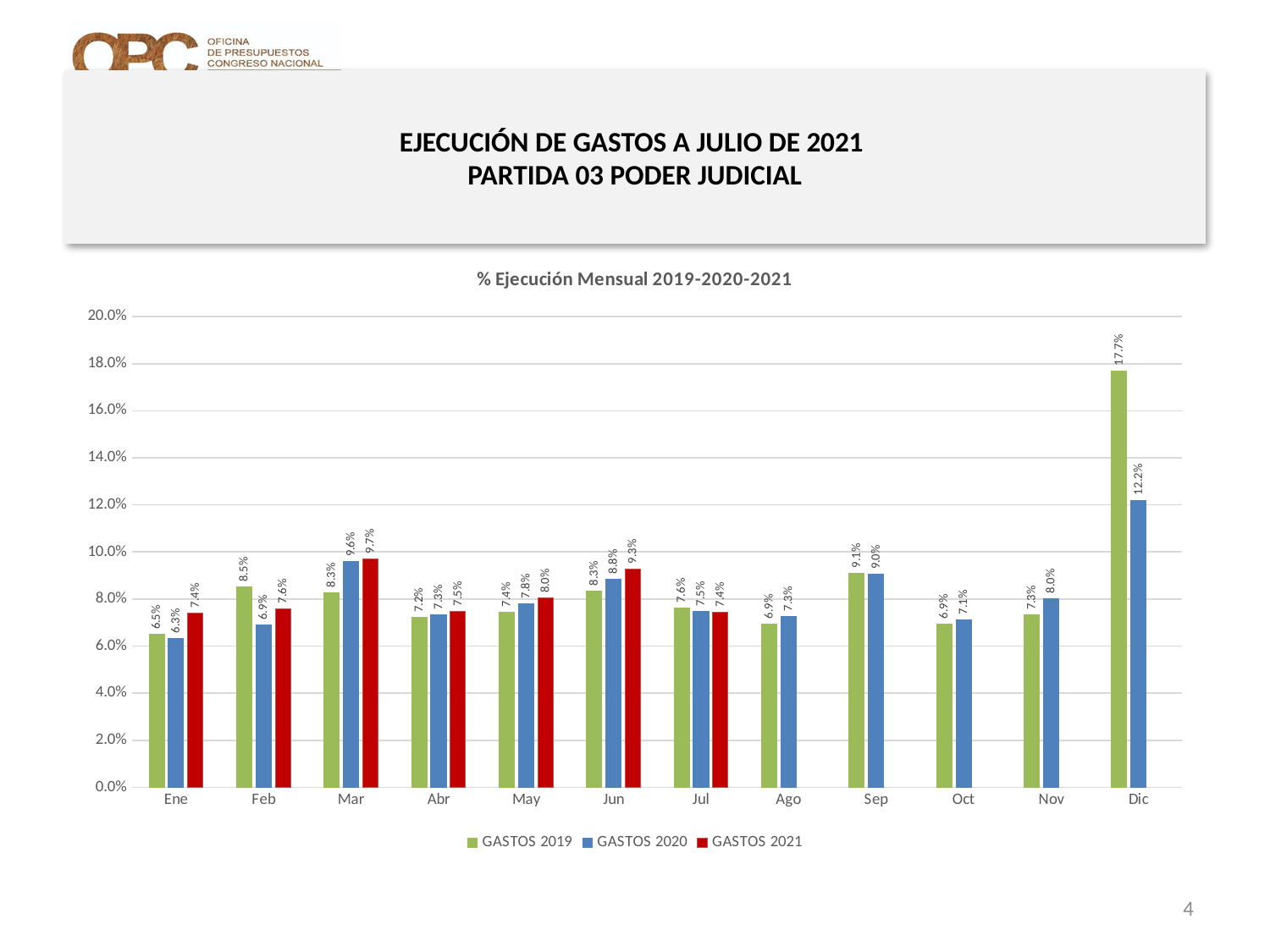
What is the difference between GASTOS 2019 and GASTOS 2020 in Dic? 5.5% What kind of chart is shown on the slide? Bar chart What is the value for GASTOS 2020 in Nov? 8.0% Is the value for GASTOS 2019 in Dic greater or less than 16.0%? greater How many months are shown on the x axis? 12 What is the value for GASTOS 2019 in Dic? 17.7% What is the value for GASTOS 2021 in Mar? 9.7% Which month has the highest value for GASTOS 2021? Mar How many series does the legend list? 3 Which month has the lowest value for GASTOS 2020? Ene Which is larger in Feb, GASTOS 2019 or GASTOS 2020? GASTOS 2019 Which month has the highest value for GASTOS 2020? Dic